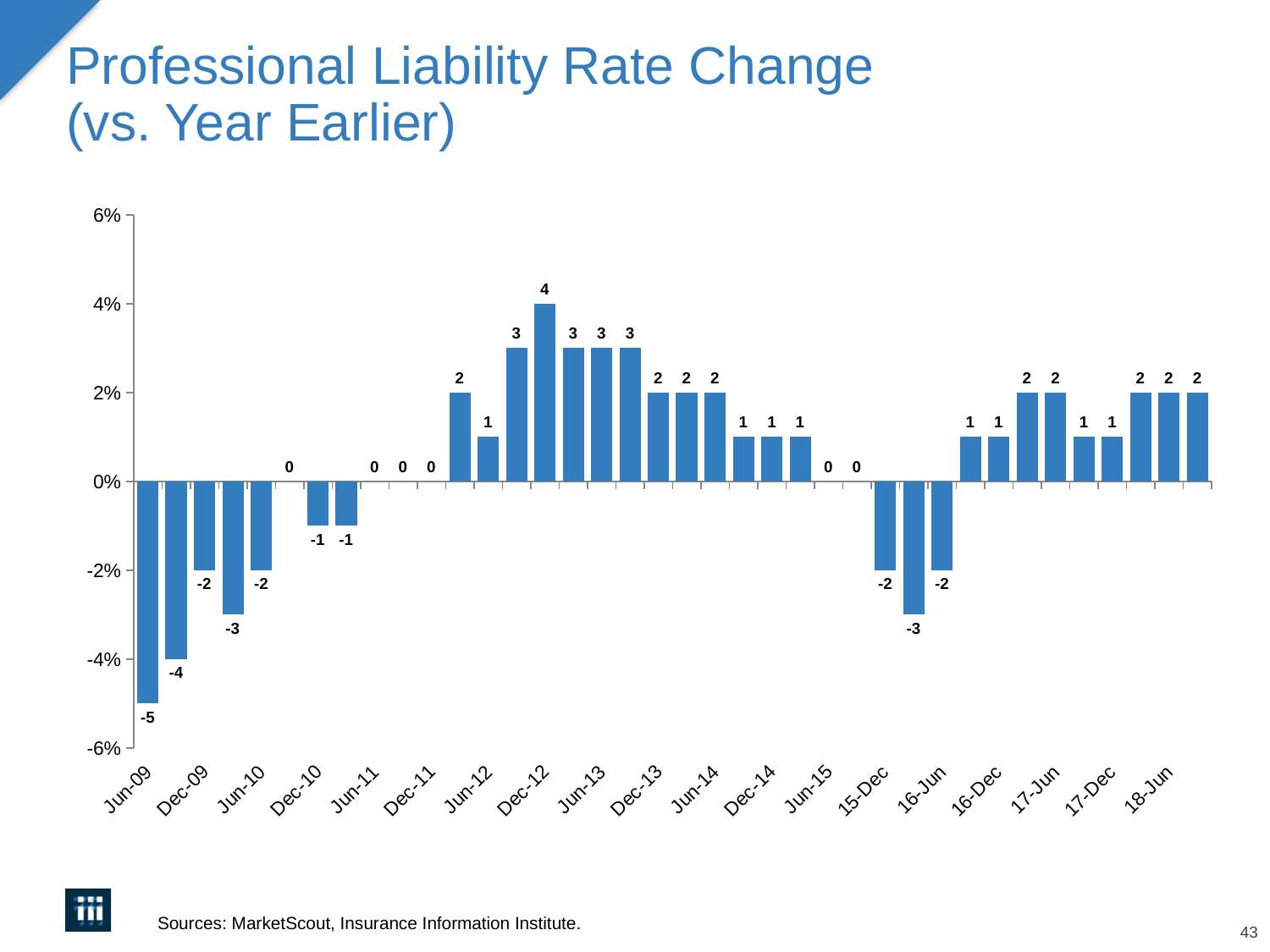
Which period has the larger rate change, Jun-13 or Dec-13? Jun-13 Do the rate change values generally rise or fall from Jun-09 to Dec-12? Rise What is the title of the chart? Professional Liability Rate Change (vs. Year Earlier) What is the rate change value labeled for 16-Jun? -2 What is the rate change value labeled for Jun-15? 0 Which period has the lowest professional liability rate change? Jun-09 What is the rate change value labeled for Dec-12? 4 What is the difference between the rate change for Dec-12 and the rate change for Jun-09? 9 What is the rate change value labeled for Jun-09? -5 What kind of chart is shown on the slide? Bar chart Which period has the highest professional liability rate change? Dec-12 What is the rate change value labeled for 17-Jun? 2